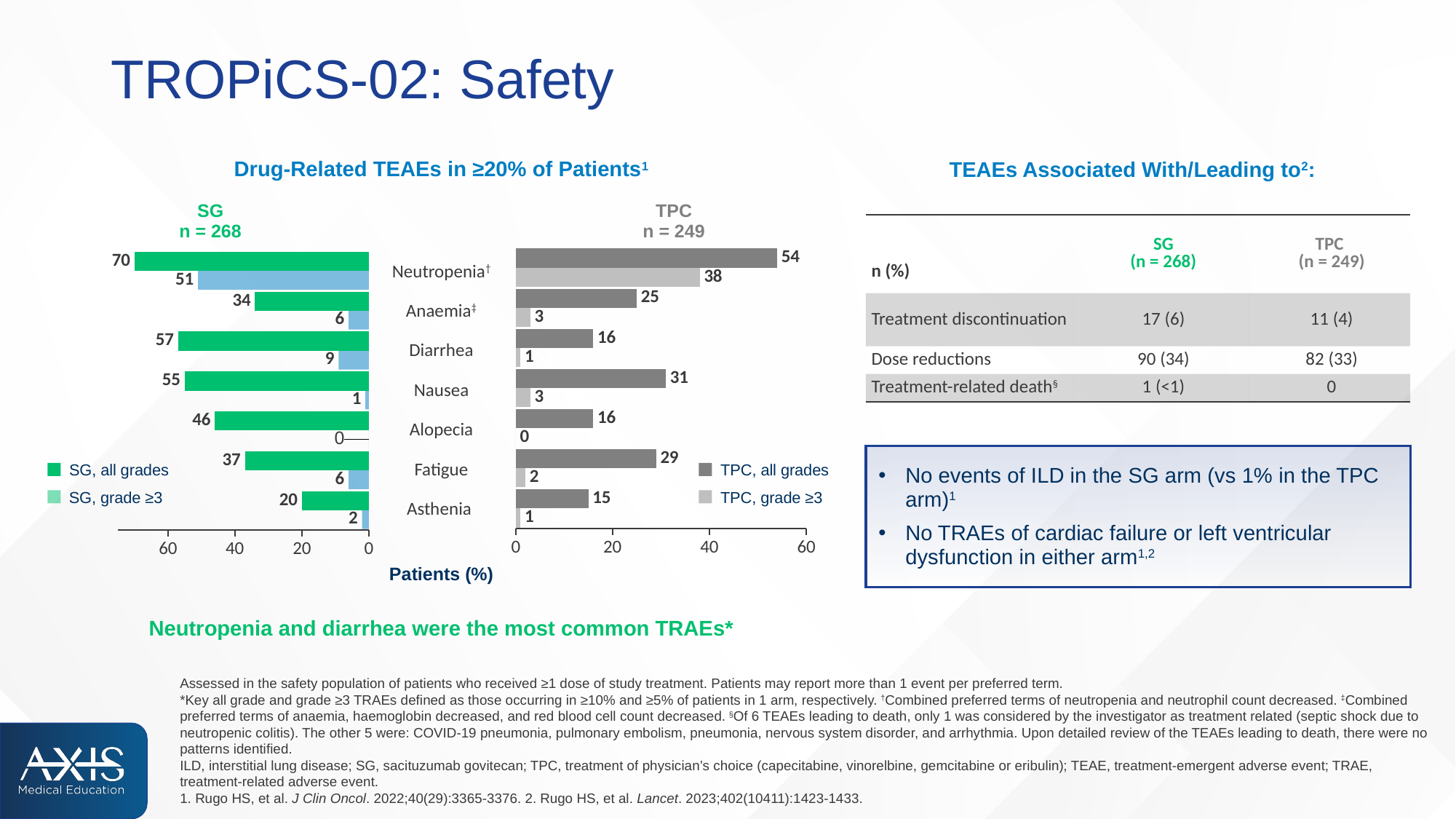
In the TPC chart, which adverse event has the lowest all-grade value? Asthenia How many adverse event categories are shown in the bar charts? 7 How many series does the legend for the SG chart list? 2 What is the x-axis label of the drug-related TEAEs chart? Patients (%) What is the difference between the SG all-grade diarrhea value and the TPC all-grade diarrhea value? 41 In the SG chart, which adverse event has the highest all-grade value? Neutropenia In the TPC chart, what percentage of patients had grade ≥3 neutropenia? 38 In the SG chart, what is the value for grade ≥3 diarrhea? 9 In the TPC chart, what is the value for all-grade nausea? 31 Which is larger: the SG all-grade alopecia value or the TPC all-grade alopecia value? SG all-grade alopecia In the SG chart, what percentage of patients had all-grade neutropenia? 70 What type of chart is used to show the drug-related TEAEs? Bar chart